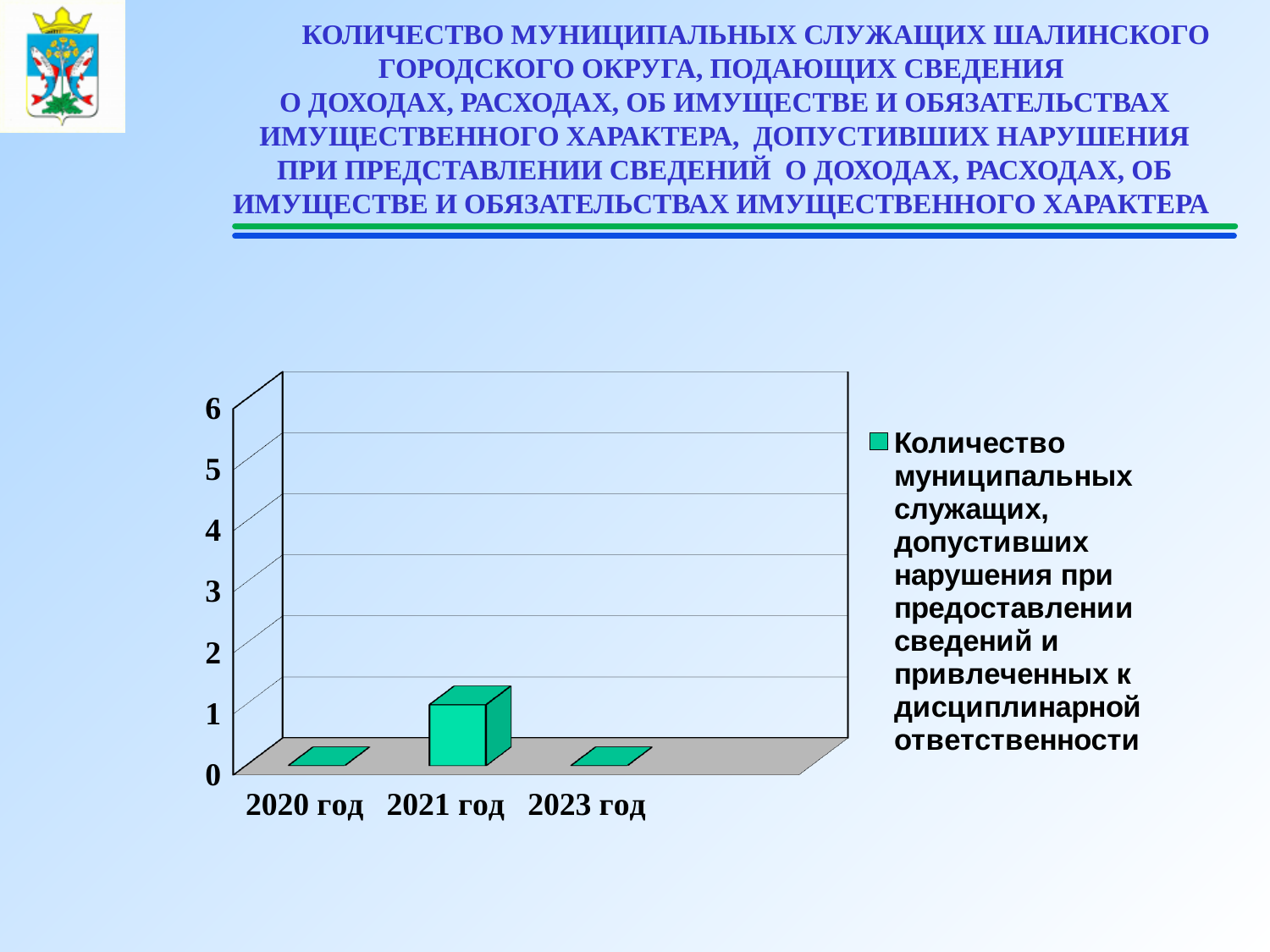
What is the highest value shown on the vertical axis of the chart? 6 What is the value for 2020 год in the chart? 0 How many categories (years) are shown on the x axis of the chart? 3 Which is larger, the value for 2021 год or the value for 2023 год? 2021 год How many series does the chart legend list? 1 What colour are the bars in the chart? green (teal) Which year has the highest value in the chart? 2021 год Is the value for 2021 год greater or less than 2? less What is the value for 2023 год in the chart? 0 What is the value for 2021 год in the chart? 1 What is the difference between the values for 2021 год and 2020 год? 1 What type of chart is shown on the slide? bar chart